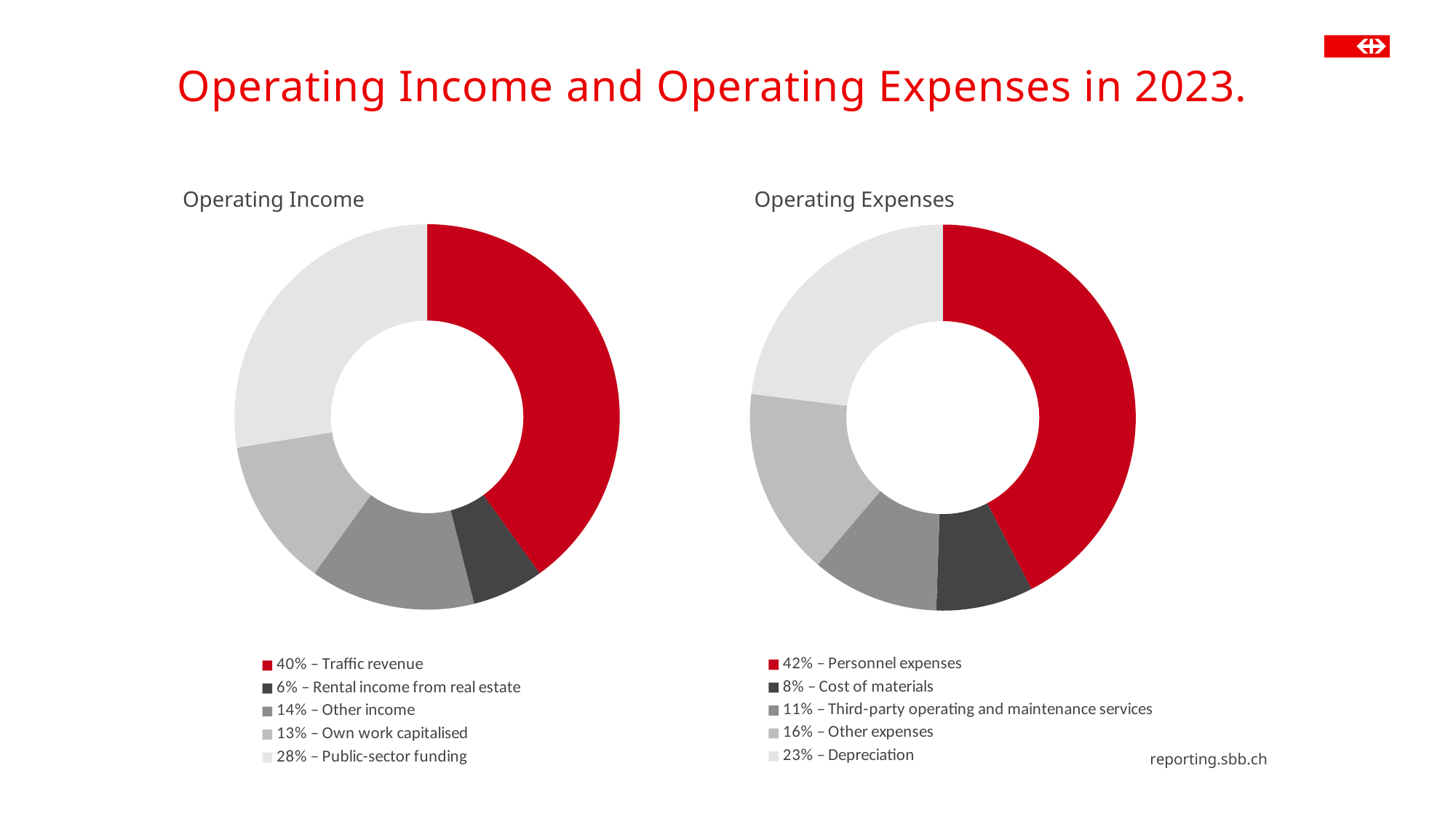
In the Operating Income chart, which category has the largest share? Traffic revenue In the Operating Income chart, which category is shown in red? Traffic revenue In the Operating Expenses chart, which is larger: Other expenses or Third-party operating and maintenance services? Other expenses How many categories does the Operating Income chart show? 5 In the Operating Income chart, what share does Own work capitalised have? 13% In the Operating Expenses chart, which category has the smallest share? Cost of materials In the Operating Expenses chart, what is the difference between the shares of Personnel expenses and Cost of materials? 34% In the Operating Income chart, what is the difference between the shares of Public-sector funding and Other income? 14% What is the title of the slide? Operating Income and Operating Expenses in 2023. In the Operating Income chart, what share does Traffic revenue have? 40% In the Operating Expenses chart, what share does Depreciation have? 23% What kind of chart is the Operating Expenses chart? Doughnut (pie) chart